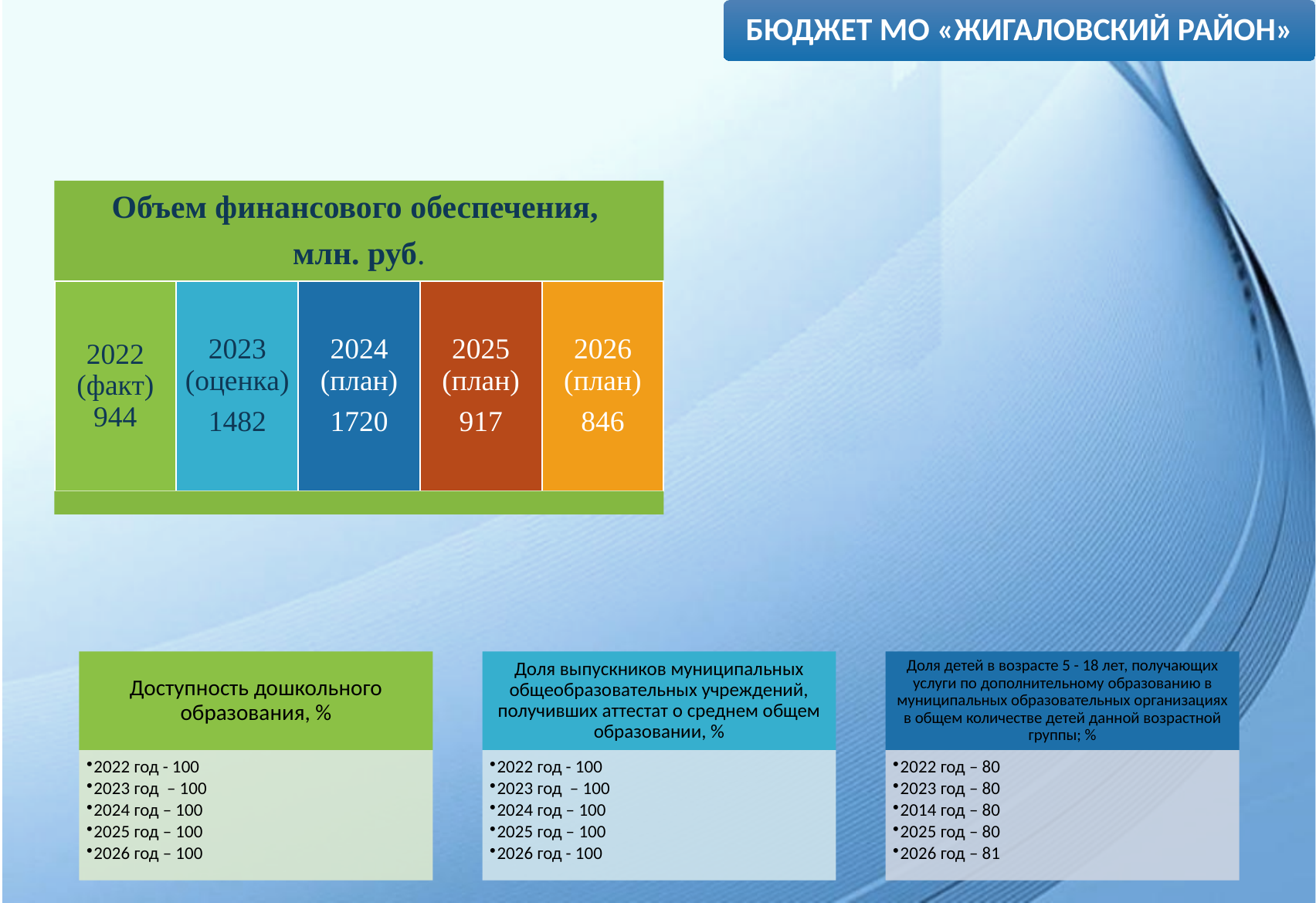
In the 'Объем финансового обеспечения, млн. руб.' graphic, which year has the highest value? 2024 (план) What unit is stated in the title of the financial graphic on the slide? млн. руб. In the 'Объем финансового обеспечения, млн. руб.' graphic, what is the planned value for 2026? 846 In the 'Объем финансового обеспечения, млн. руб.' graphic, what is the planned value for 2024? 1720 In the 'Объем финансового обеспечения, млн. руб.' graphic, what is the difference between the 2024 (план) value and the 2022 (факт) value? 776 How many years are shown in the 'Объем финансового обеспечения, млн. руб.' graphic? 5 In the 'Объем финансового обеспечения, млн. руб.' graphic, do the values rise or fall from 2024 to 2026? fall In the 'Объем финансового обеспечения, млн. руб.' graphic, what is the value for 2023 (оценка)? 1482 In the 'Объем финансового обеспечения, млн. руб.' graphic, which is larger: the value for 2025 (план) or the value for 2026 (план)? 2025 (план) In the 'Объем финансового обеспечения, млн. руб.' graphic, what is the difference between the 2023 (оценка) value and the 2025 (план) value? 565 In the 'Объем финансового обеспечения, млн. руб.' graphic, what is the value for 2022 (факт)? 944 In the 'Объем финансового обеспечения, млн. руб.' graphic, which year has the lowest value? 2026 (план)